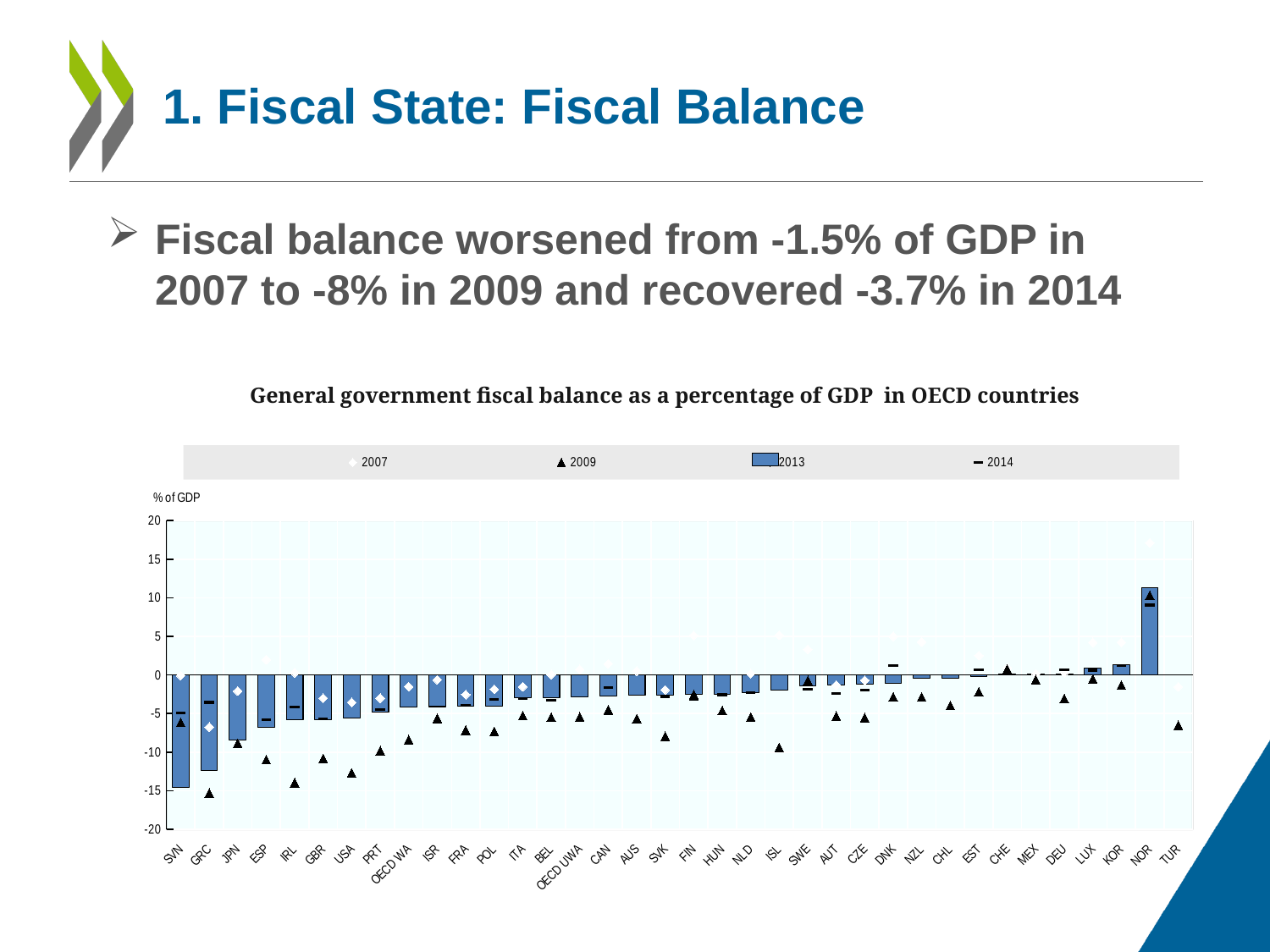
Do the 2013 bars generally rise or fall moving from left to right along the x axis? rise What is the title of the chart? General government fiscal balance as a percentage of GDP in OECD countries How many countries or groups are shown along the x axis of the chart? 36 Is the 2013 value for NOR greater or less than 10? greater Is the 2009 value for IRL greater or less than -10? less Which country has the lowest 2013 bar in the chart? SVN Which has the lower 2013 bar, JPN or ESP? JPN Which country has the highest 2013 bar in the chart? NOR What kind of chart is shown on the slide? bar chart Is the 2013 value for SVN greater or less than -10? less Which years are listed in the chart legend? 2007, 2009, 2013, 2014 How many series does the chart legend list? 4